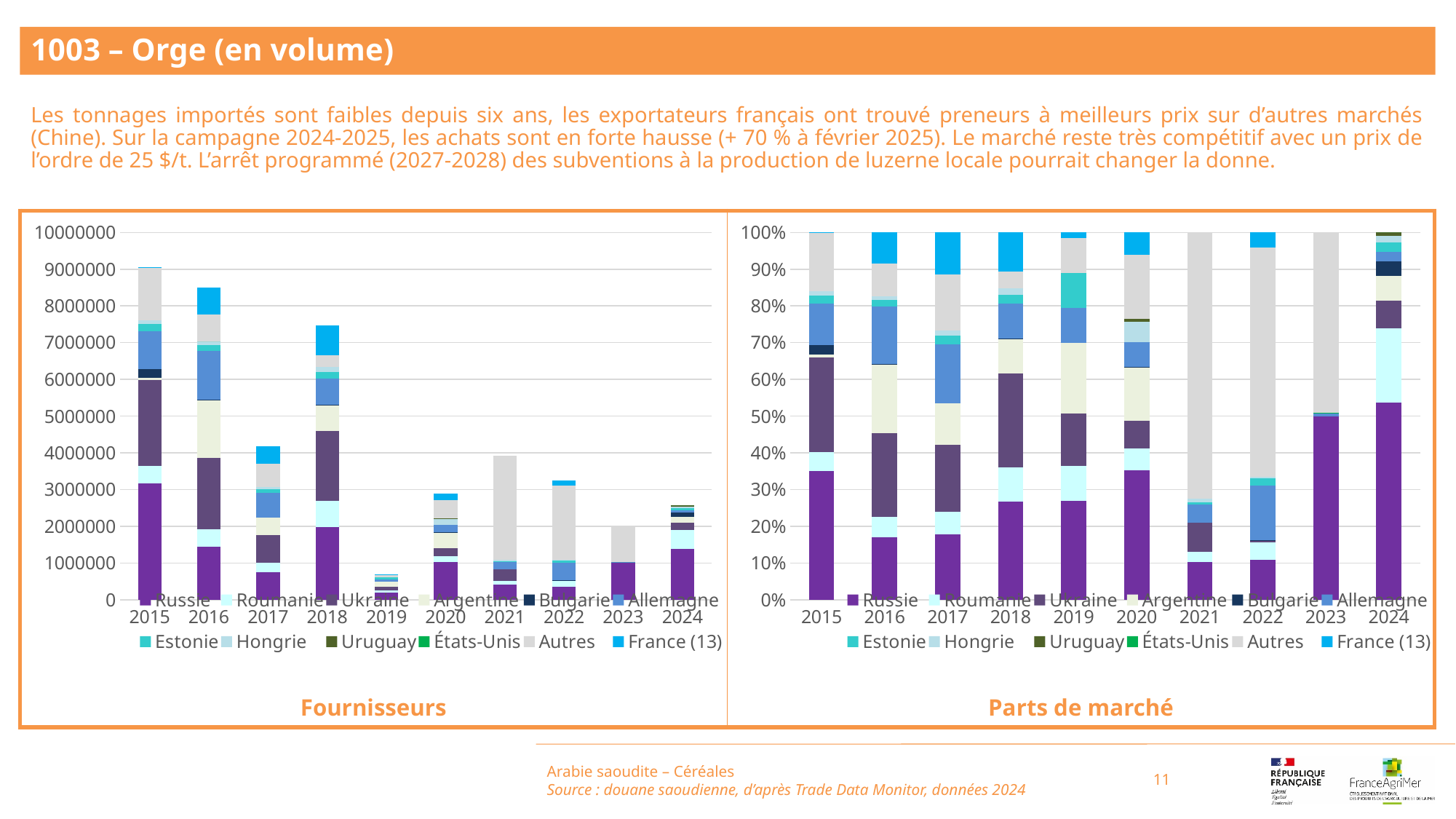
What kind of chart is the 'Parts de marché' chart? 100% stacked bar chart Which series is listed first in the legend of the 'Fournisseurs' chart? Russie In the 'Fournisseurs' chart, is the total for 2022 greater or less than 3000000? greater In the 'Parts de marché' chart, is the share of Russie in 2015 greater or less than 30%? greater In the 'Fournisseurs' chart, how many years are shown on the x axis? 10 In the 'Fournisseurs' chart, is the total for 2019 greater or less than 1000000? less In the 'Parts de marché' chart, how many series does the legend list? 12 In the 'Fournisseurs' chart, which year has the lowest total bar? 2019 In the 'Parts de marché' chart, is the share of Russie larger in 2024 or in 2021? 2024 In the 'Fournisseurs' chart, which year has the highest total bar? 2015 What kind of chart is the 'Fournisseurs' chart? stacked bar chart